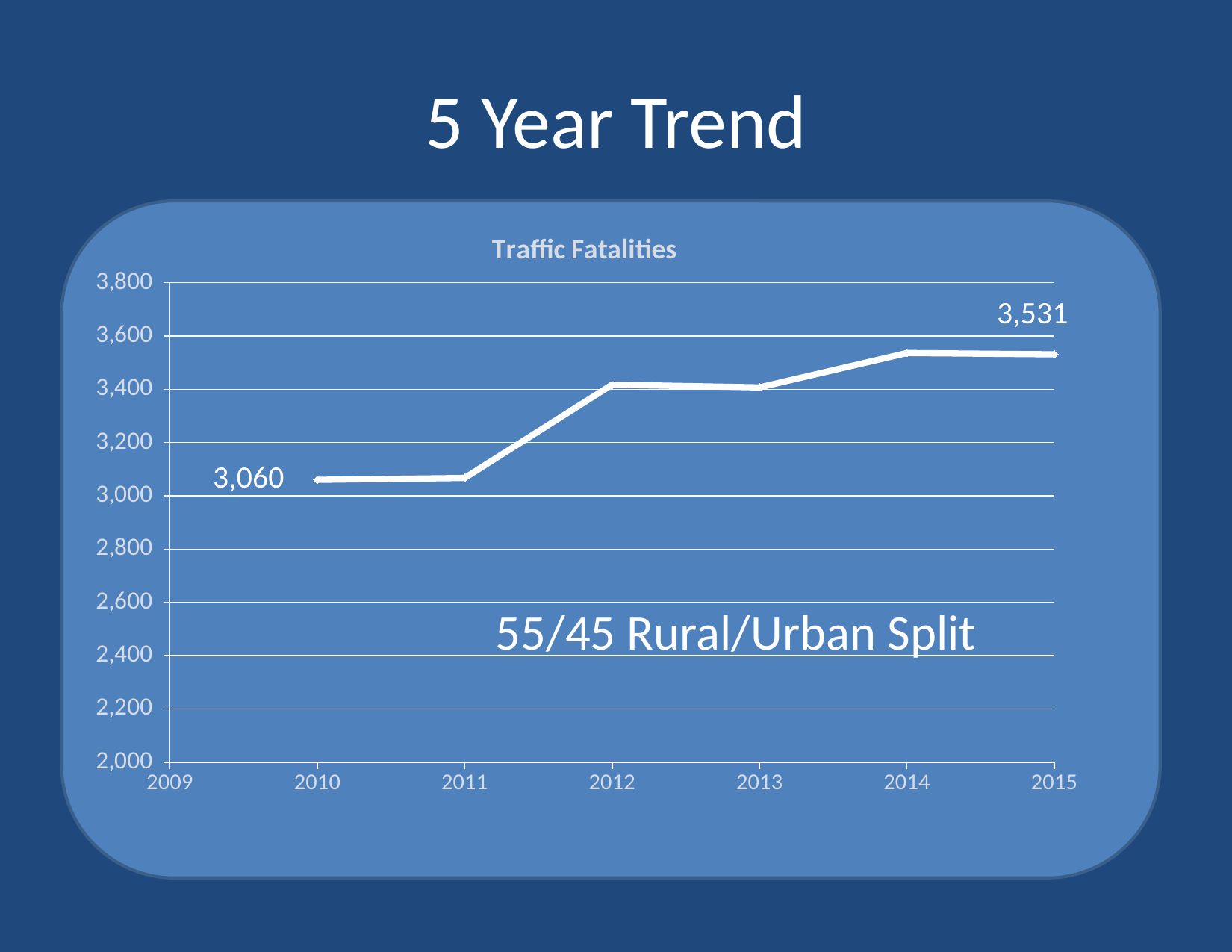
What is the value for 2010 on the Traffic Fatalities chart? 3,060 Which year has the larger value, 2010 or 2012? 2012 Do traffic fatalities generally rise or fall from 2010 to 2015? Rise Is the value for 2013 greater or less than 3,600? less What kind of chart is shown on the slide? Line chart How many years have a plotted data point on the Traffic Fatalities chart? 6 By how much did traffic fatalities increase from 2010 to 2015? 471 Is the value for 2011 greater or less than 3,200? less Is the value for 2012 greater or less than 3,200? greater Which year has the larger value, 2012 or 2014? 2014 What text annotation is written inside the chart area? 55/45 Rural/Urban Split What is the value for 2015 on the Traffic Fatalities chart? 3,531